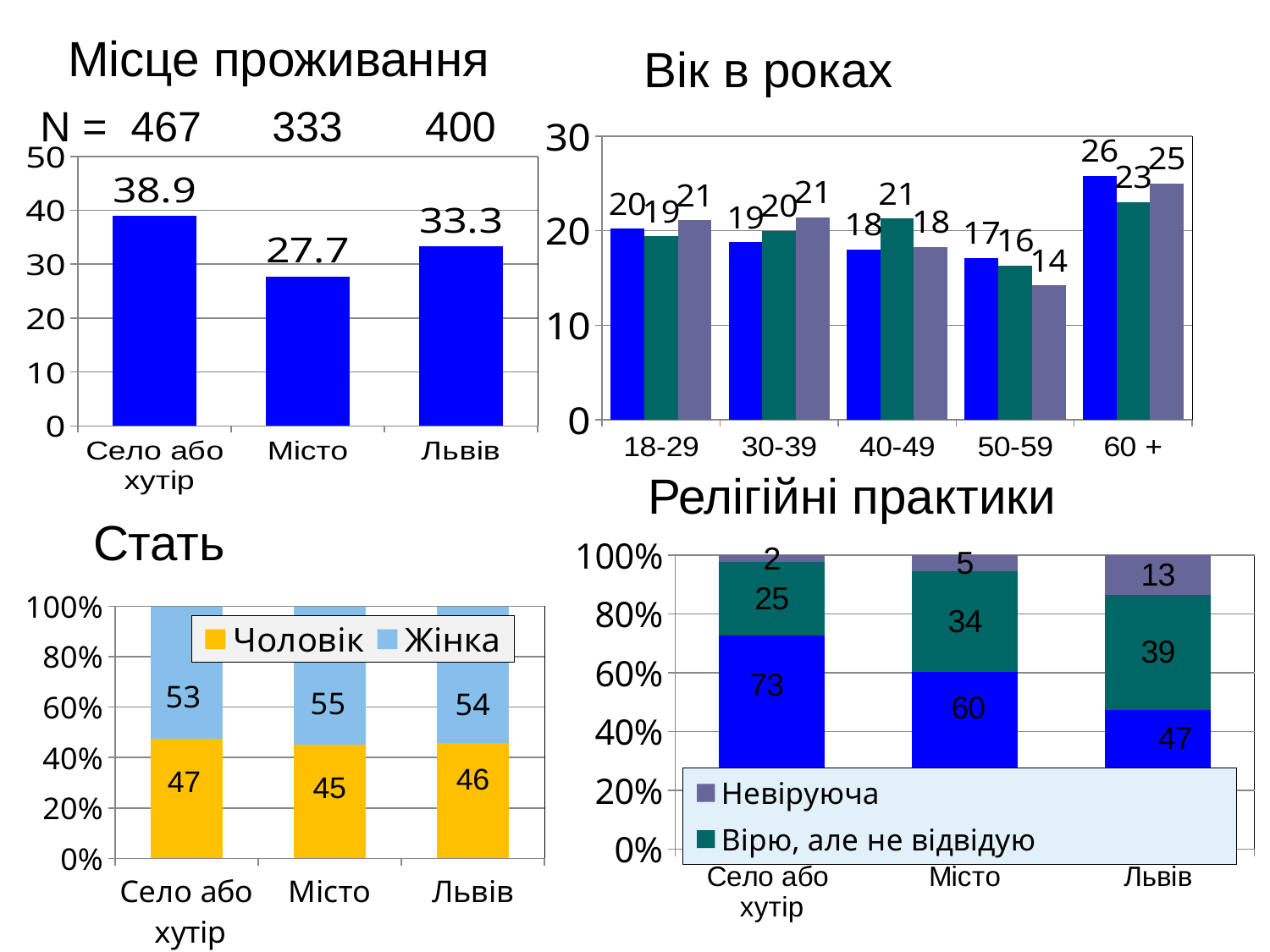
How many age groups are shown on the x axis of the "Вік в роках" chart? 5 How many series does the legend of the "Стать" chart list? 2 In the "Вік в роках" chart, which age group has the lowest value for the grey series? 50-59 In the "Місце проживання" chart, which category has the highest value? Село або хутір In the "Релігійні практики" chart, what is the value for Невіруюча in Львів? 13 In the "Вік в роках" chart, is the blue bar for 60 + greater or less than 20? greater In the "Місце проживання" chart, what is the difference between the values for Село або хутір and Львів? 5.6 In the "Стать" chart, what is the value for Жінка in Місто? 55 What kind of chart is the "Місце проживання" chart? bar chart In the "Вік в роках" chart, what is the value of the blue bar for the 60 + group? 26 In the "Релігійні практики" chart, which category has the largest value for "Вірю, але не відвідую"? Львів In the "Місце проживання" chart, what is the value for Місто? 27.7